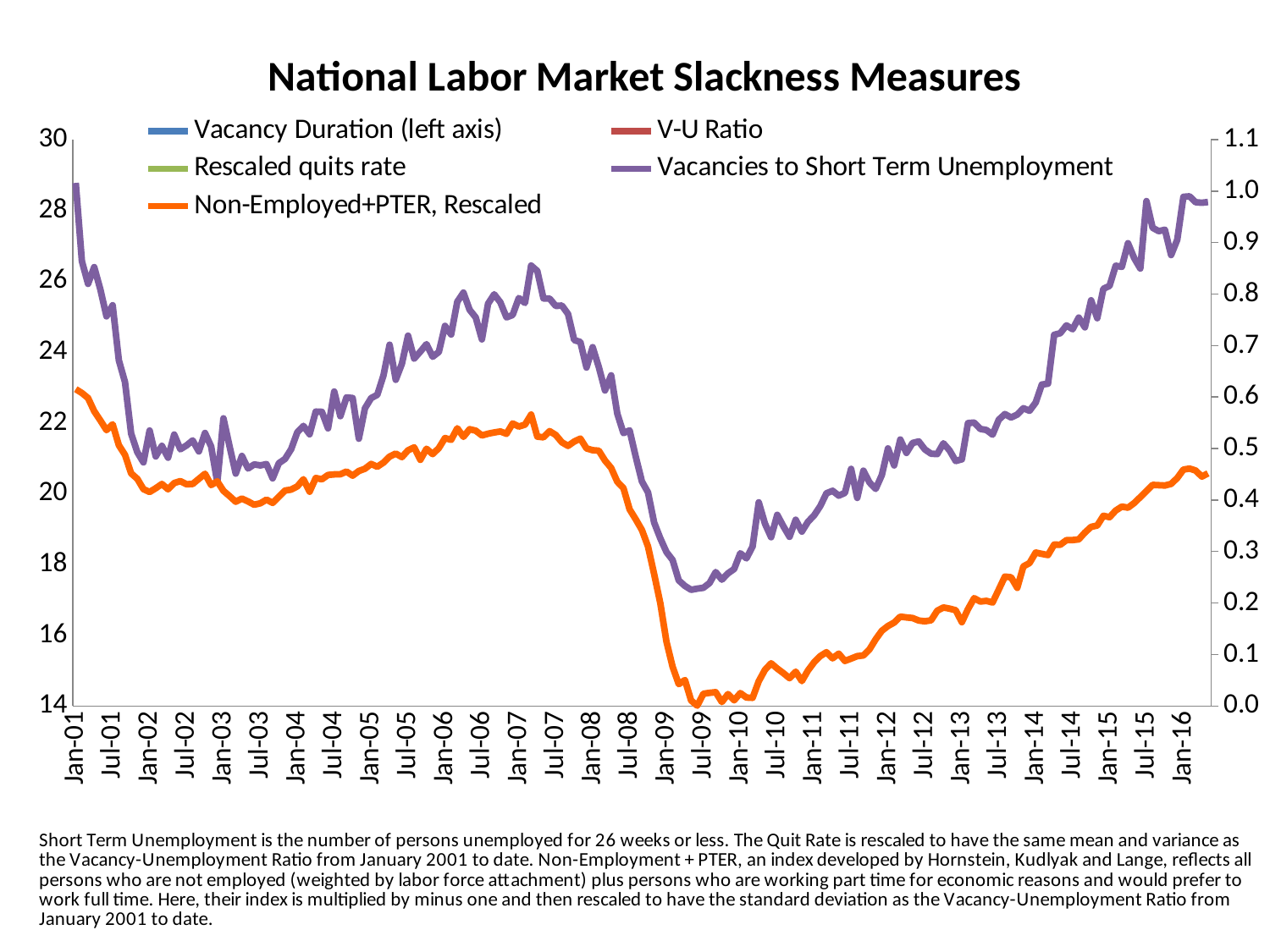
What is the highest value shown on the right-hand axis? 1.1 Which of the two plotted lines reaches the lowest point on the chart? Non-Employed+PTER, Rescaled What kind of chart is shown on the slide? line chart Does the Non-Employed+PTER, Rescaled line rise or fall between Jan-07 and Jan-09? fall Does the Vacancies to Short Term Unemployment line rise or fall between Jan-01 and Jan-02? fall On the right axis, is the value of the Vacancies to Short Term Unemployment line at Jul-09 greater or less than 0.3? less On the right axis, is the value of the Vacancies to Short Term Unemployment line at Jan-08 greater or less than 0.6? greater On the right axis, is the value of the Vacancies to Short Term Unemployment line at Jan-16 greater or less than 0.9? greater Does the Vacancies to Short Term Unemployment line rise or fall between Jan-09 and Jan-16? rise How many series does the chart's legend list? 5 What is the title of the chart? National Labor Market Slackness Measures